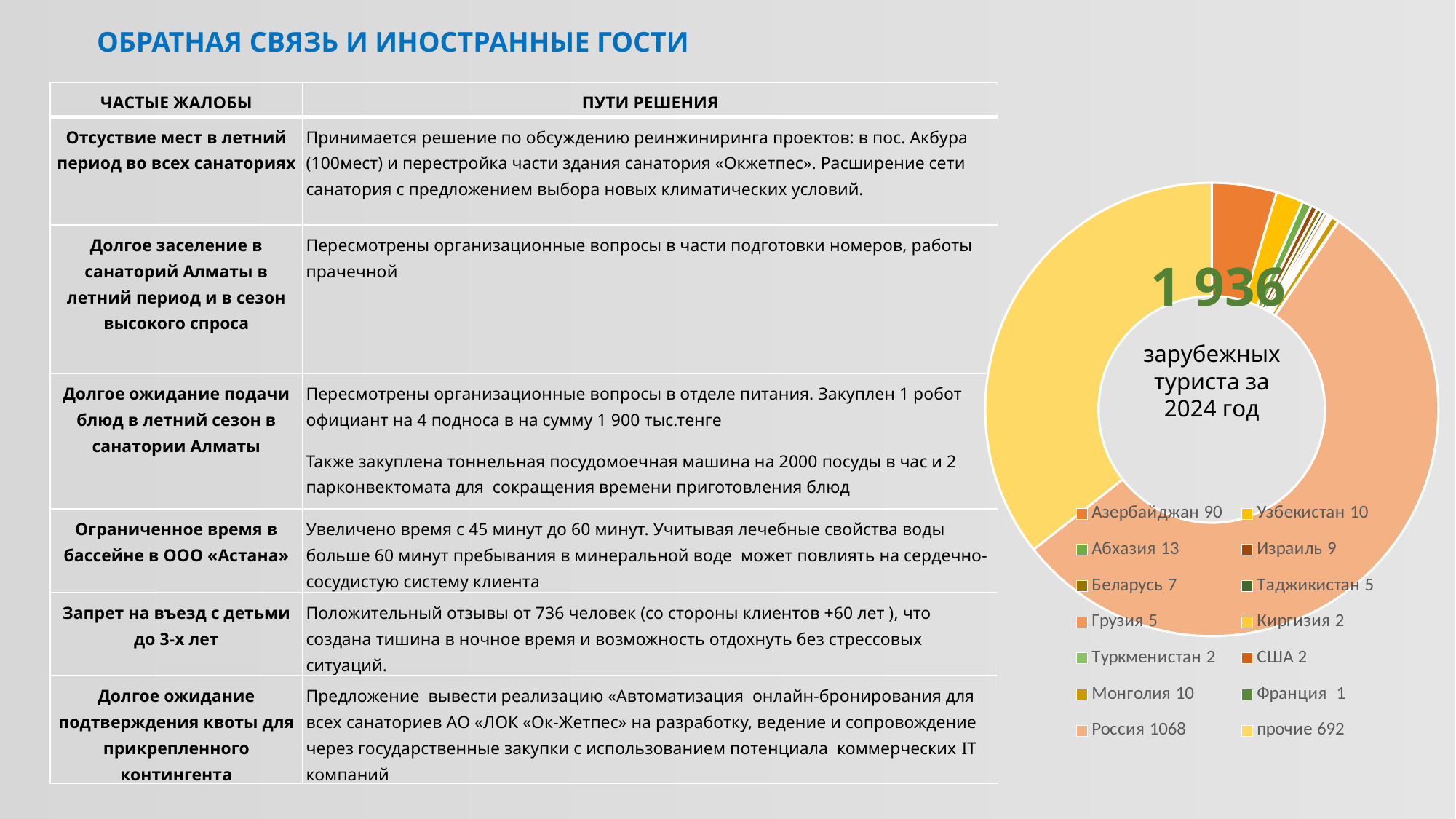
What is the difference between the values for Азербайджан and Абхазия? 77 What value is shown for Россия in the pie chart legend? 1068 Which category has the smallest value in the pie chart? Франция Which category has the largest value in the pie chart? Россия Which is larger, the value for Узбекистан or the value for Израиль? Узбекистан What is the difference between the values for Россия and прочие? 376 What value is shown for прочие in the pie chart legend? 692 How many categories does the legend of the pie chart list? 14 What total number is printed in the centre of the donut chart? 1 936 What value is shown for Азербайджан in the pie chart legend? 90 What kind of chart is shown on the slide? Pie (donut) chart What value is shown for Абхазия in the pie chart legend? 13